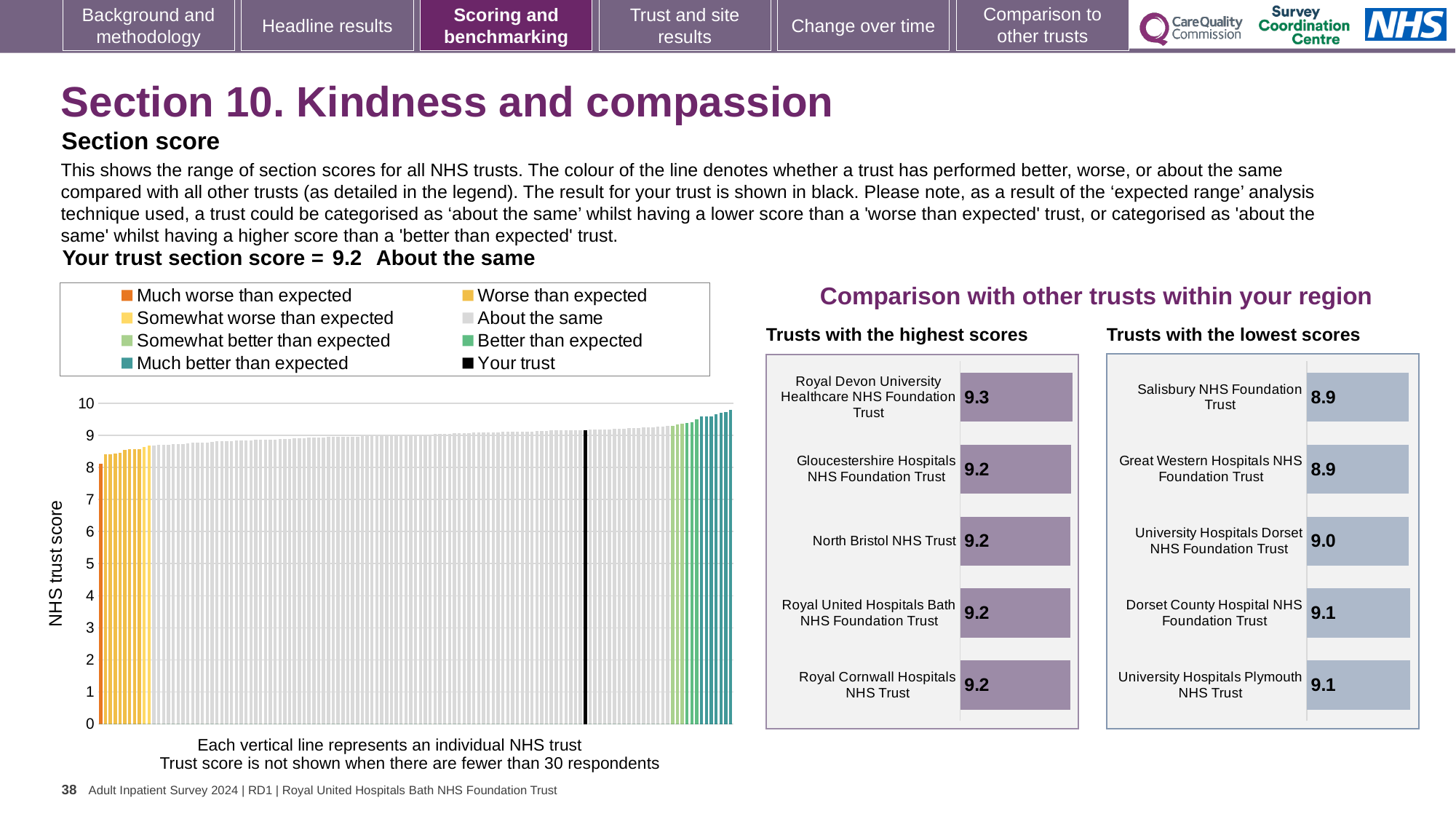
In the 'Trusts with the highest scores' chart, what is the score for Royal Devon University Healthcare NHS Foundation Trust? 9.3 In the large 'NHS trust score' chart on the left, do the bar values rise or fall from left to right along the x axis? Rise In the large 'NHS trust score' chart on the left, is the value of the tallest bar greater or less than 9? greater In the 'Trusts with the lowest scores' chart, what is the score for University Hospitals Dorset NHS Foundation Trust? 9.0 In the 'Trusts with the highest scores' chart, what is the difference between the scores of Royal Devon University Healthcare NHS Foundation Trust and Gloucestershire Hospitals NHS Foundation Trust? 0.1 In the 'Trusts with the highest scores' chart, which trust has the highest score? Royal Devon University Healthcare NHS Foundation Trust In the 'Trusts with the lowest scores' chart, what is the score for Salisbury NHS Foundation Trust? 8.9 In the 'Trusts with the highest scores' chart, which has the larger score: Royal Devon University Healthcare NHS Foundation Trust or North Bristol NHS Trust? Royal Devon University Healthcare NHS Foundation Trust In the 'Trusts with the lowest scores' chart, what is the difference between the scores of Dorset County Hospital NHS Foundation Trust and Great Western Hospitals NHS Foundation Trust? 0.2 What kind of chart is the large 'NHS trust score' chart on the left of the slide? Bar chart How many trusts are shown in the 'Trusts with the lowest scores' chart? 5 How many entries does the legend of the large 'NHS trust score' chart on the left list? 8